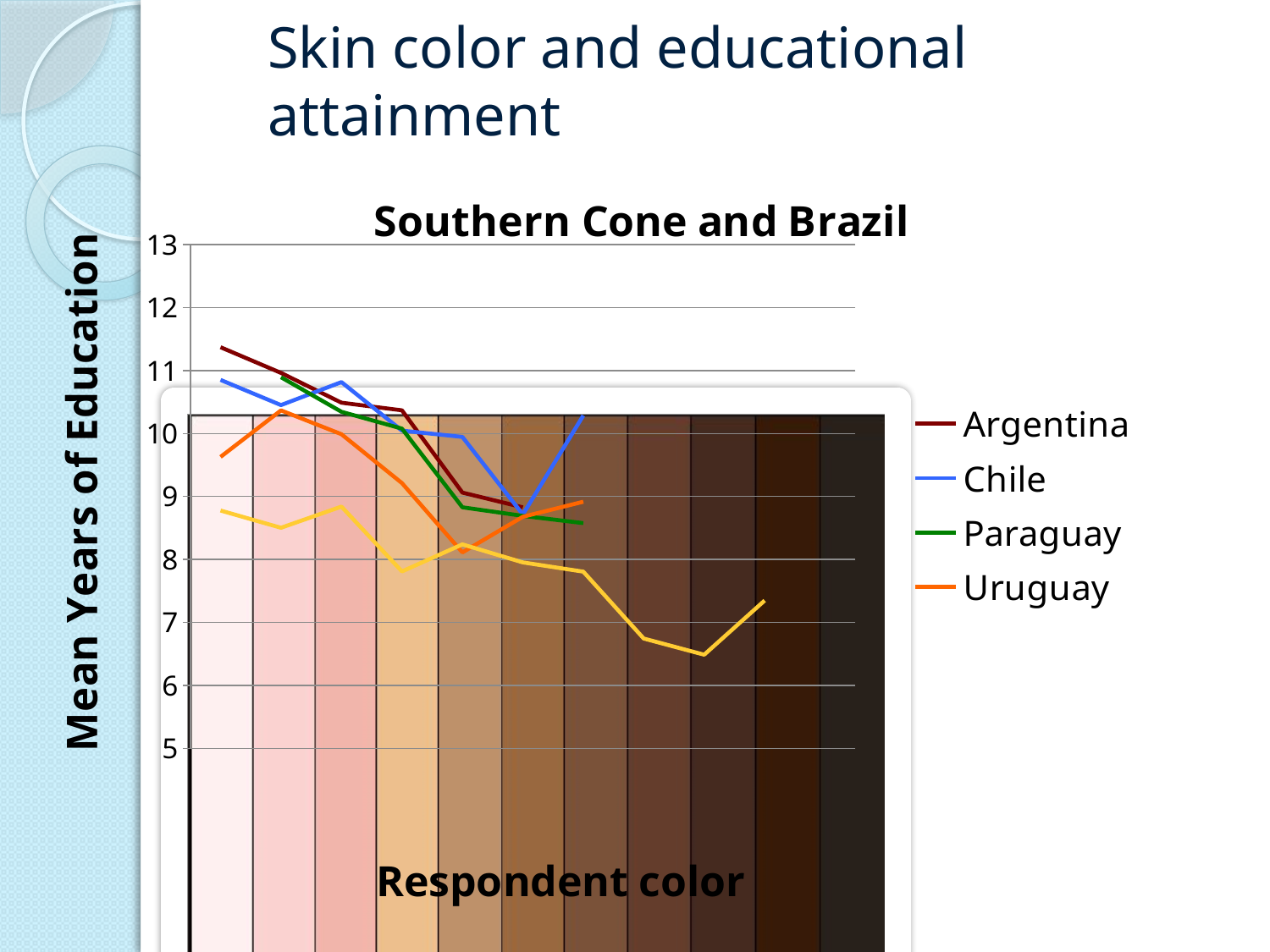
What kind of chart is shown on the slide? line chart Is the value for Argentina at the leftmost (lightest) respondent color greater or less than 11? greater Is the value for Chile at the leftmost (lightest) respondent color greater or less than 11? less What is the title of the chart? Southern Cone and Brazil Which legend series has the highest value at the leftmost (lightest) respondent color? Argentina Which legend series has the lowest value at the leftmost (lightest) respondent color? Uruguay At the leftmost (lightest) respondent color, which is higher: Argentina or Uruguay? Argentina Does the Argentina line generally rise or fall as respondent color moves from lighter to darker? fall Is the value for Uruguay at the leftmost (lightest) respondent color greater or less than 10? less What is the label of the vertical axis? Mean Years of Education How many series does the chart legend list? 4